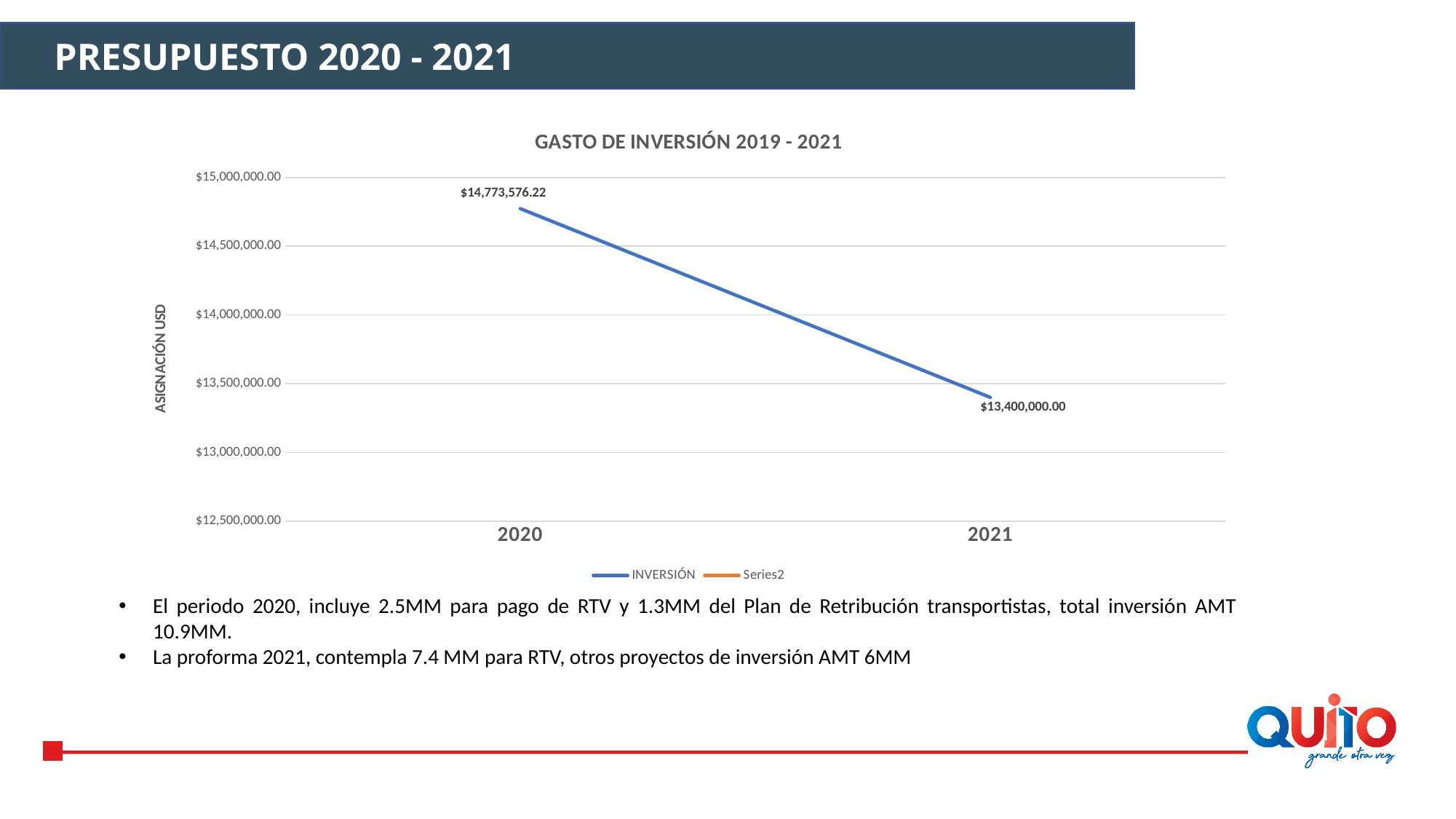
Is the value for 2020 greater or less than $14,500,000.00? greater Does the line rise or fall from 2020 to 2021? fall How many series does the legend list? 2 What is the value for 2020 in the chart? $14,773,576.22 What kind of chart is shown? line chart What is the difference between the 2020 and 2021 values? $1,373,576.22 What is the value for 2021 in the chart? $13,400,000.00 What is the title of the chart? GASTO DE INVERSIÓN 2019 - 2021 Which year has the lower investment value? 2021 Which year has the higher investment value? 2020 How many years are plotted on the x axis? 2 Is the value for 2021 greater or less than $13,500,000.00? less